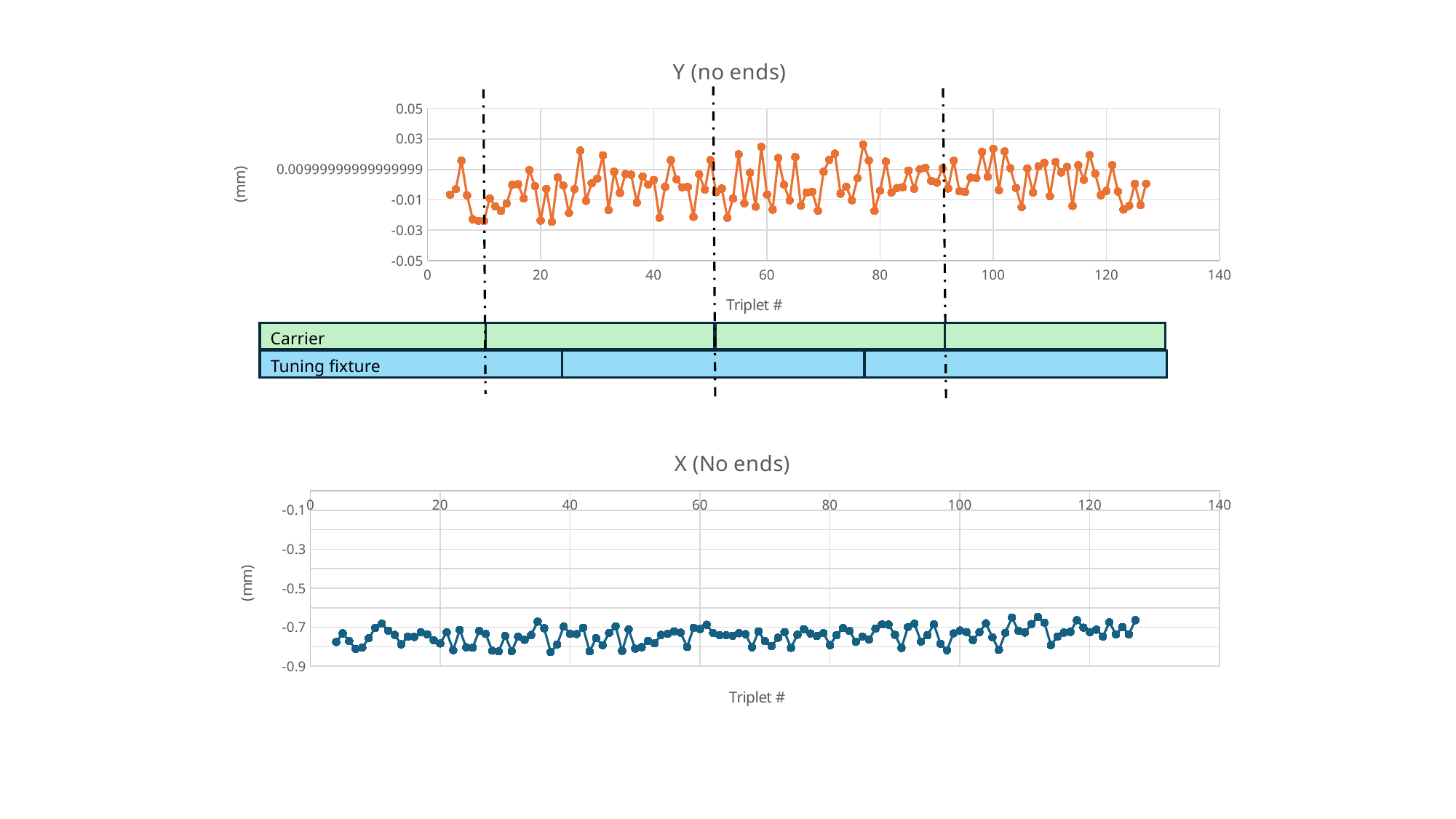
In the 'Y (no ends)' chart, is the value at triplet 20 greater or less than 0.03? less In the 'X (No ends)' chart, is the value at triplet 60 greater or less than -0.5? less In the 'Y (no ends)' chart, is the value at triplet 10 greater or less than -0.01? less What kind of chart is the 'Y (no ends)' chart? line chart What kind of chart is the 'X (No ends)' chart? line chart What is the title of the top chart on the slide? Y (no ends) In the 'X (No ends)' chart, do the values show a strong rising or falling trend along the x axis, or stay roughly flat? roughly flat What is the highest tick value shown on the x axis of the 'Y (no ends)' chart? 140 What is the x-axis label of the 'X (No ends)' chart? Triplet #